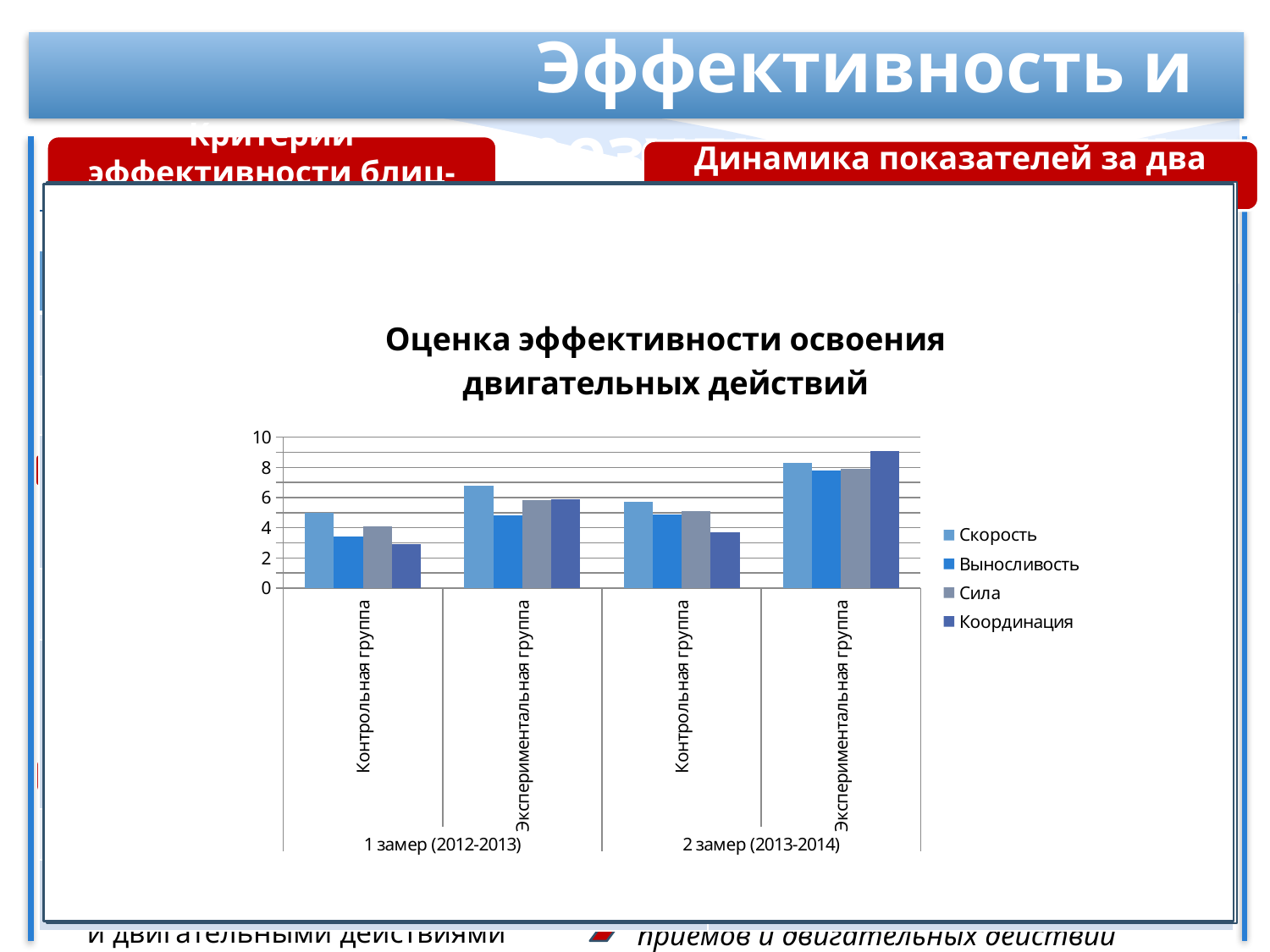
What is the title of the chart? Оценка эффективности освоения двигательных действий Which series has the lowest bar in the whole chart? Координация (Контрольная группа, 1 замер) What kind of chart is shown on the slide? bar chart In Контрольная группа (1 замер), which is larger: Скорость or Координация? Скорость Is the value for Выносливость in Контрольная группа (1 замер) greater or less than 4? less Is the value for Координация in Экспериментальная группа (2 замер) greater or less than 8? greater How many series does the legend list? 4 Is the value for Скорость in Экспериментальная группа (1 замер) greater or less than 6? greater How many category groups (groups of bars) are shown on the x axis? 4 For Экспериментальная группа, does the Скорость value rise or fall from 1 замер (2012-2013) to 2 замер (2013-2014)? rise Which series has the highest bar in the whole chart? Координация (Экспериментальная группа, 2 замер)